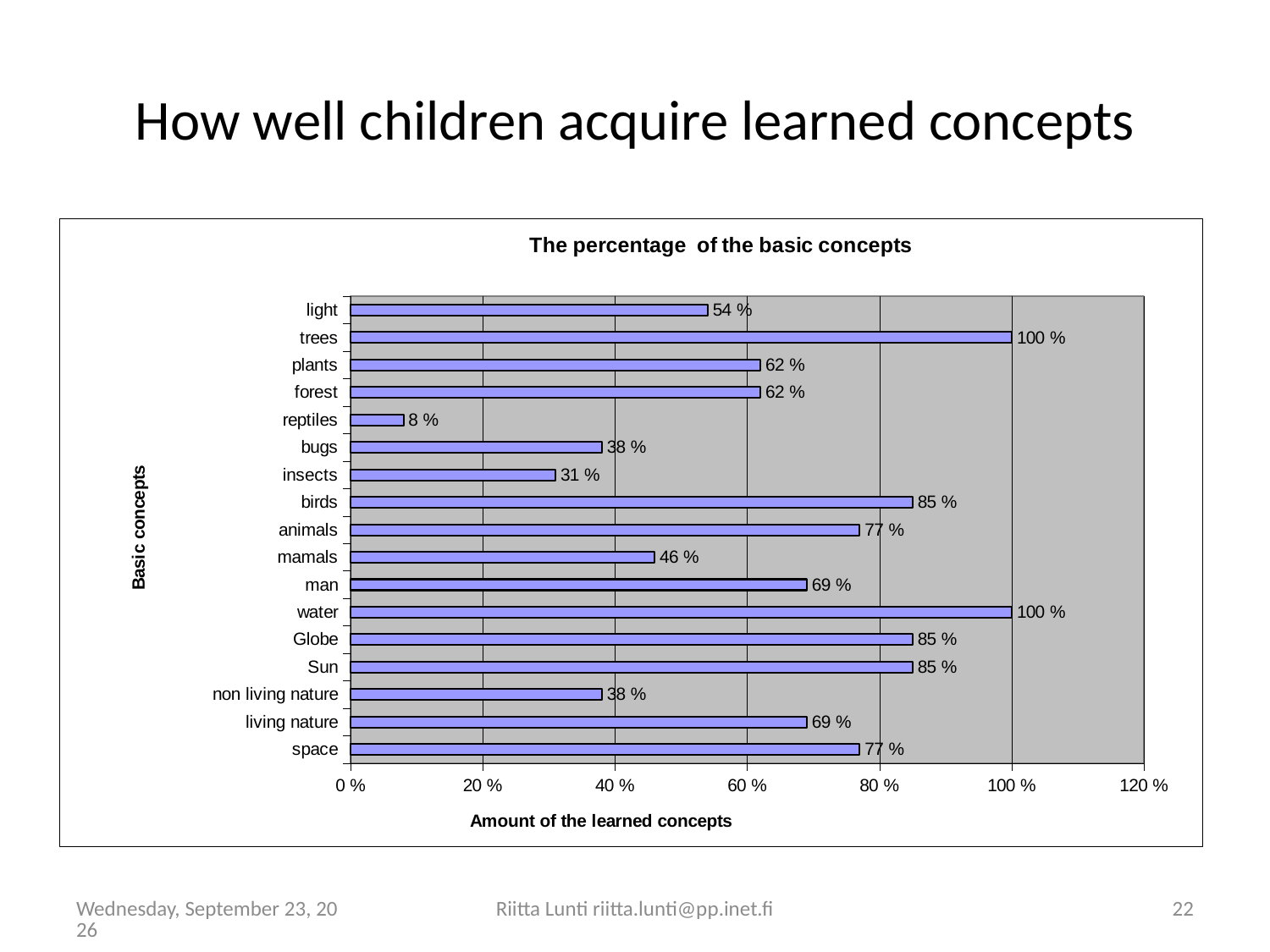
Which is larger, the value for man or the value for bugs? man What is the value for non living nature? 38 % Is the value for space greater or less than 60 %? greater What is the value for mamals? 46 % What is the value for reptiles? 8 % What kind of chart is shown on the slide? bar chart What is the title of the chart? The percentage of the basic concepts What is the value for birds? 85 % How many categories are shown on the chart? 17 Which category has the lowest value? reptiles What is the difference between the values for trees and light? 46 % What is the difference between the values for animals and insects? 46 %